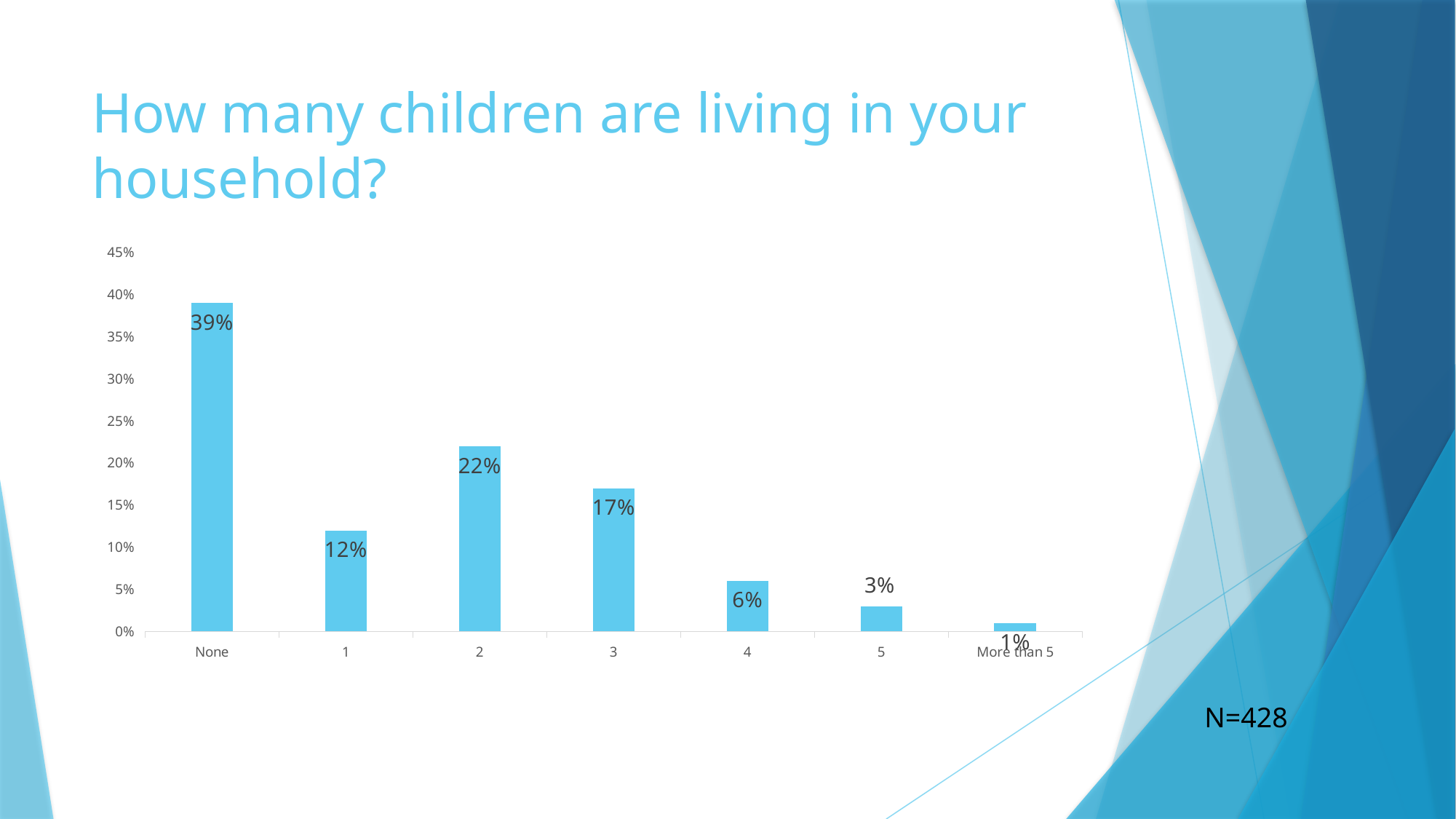
What kind of chart is shown on the slide? Bar chart Which is larger, the value for 1 child or the value for 3 children? 3 children Which category has the lowest value? More than 5 Which category has the highest value? None What is the value for households with 3 children? 17% What is the difference between the values for '1' and '4'? 6% How many categories are shown on the x axis? 7 What percentage of respondents have no children living in their household? 39% What is the value for households with 2 children? 22% What is the difference between the values for 'None' and '2'? 17% What is the value for the 'More than 5' category? 1% What sample size is noted on the slide? N=428